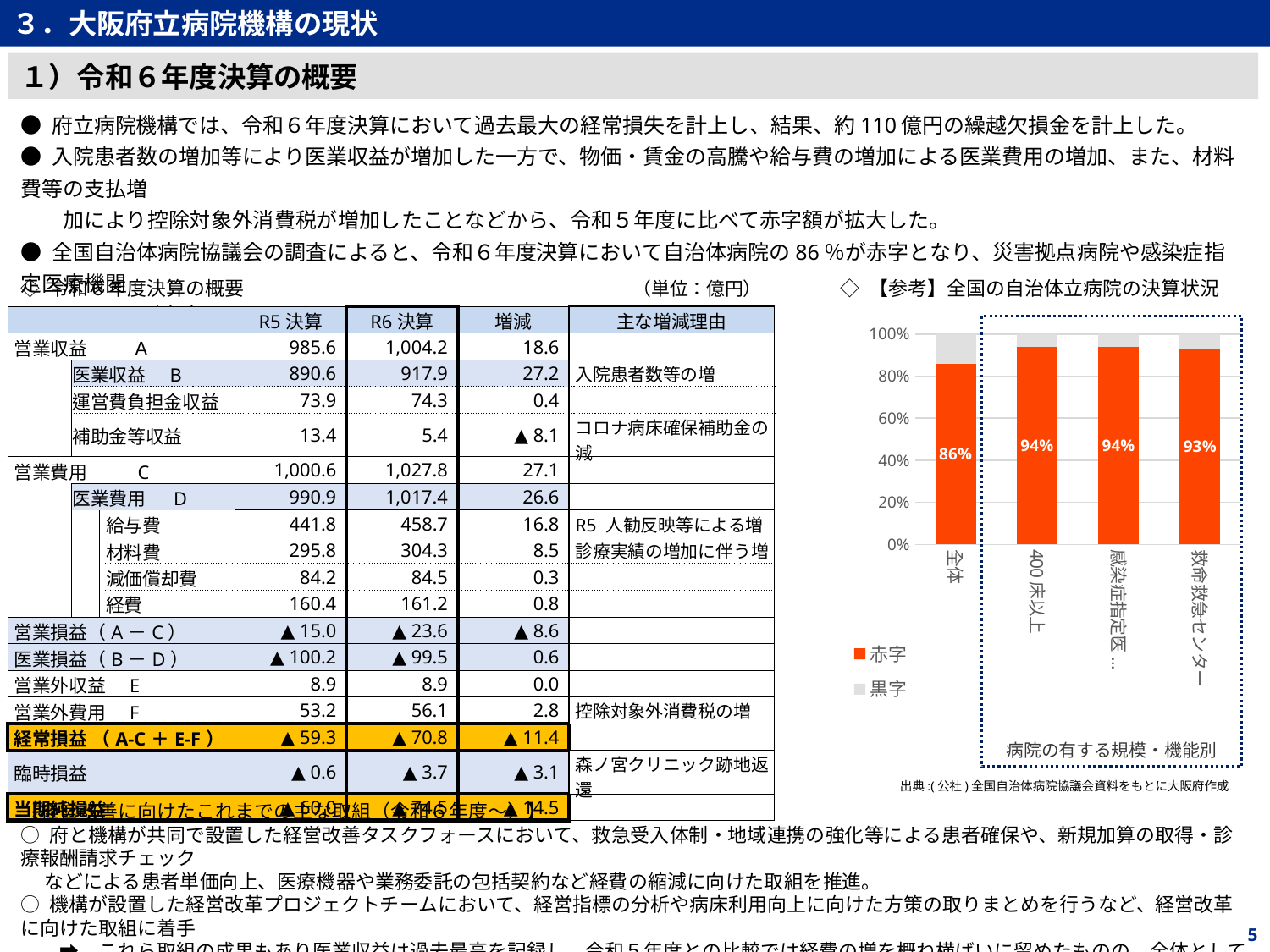
In the chart 【参考】全国の自治体立病院の決算状況, what is the difference between the 赤字 percentage for 400床以上 and for 全体? 8 percentage points What are the two legend entries in the chart 【参考】全国の自治体立病院の決算状況? 赤字 and 黒字 In the chart 【参考】全国の自治体立病院の決算状況, is the 赤字 value for 全体 greater or less than 80%? greater How many series does the legend of the chart 【参考】全国の自治体立病院の決算状況 list? 2 In the chart 【参考】全国の自治体立病院の決算状況, which category has the lowest 赤字 percentage? 全体 In the chart 【参考】全国の自治体立病院の決算状況, what is the 赤字 percentage for 400床以上? 94% In the chart 【参考】全国の自治体立病院の決算状況, what is the 赤字 percentage for 救命救急センター? 93% What kind of chart is shown on the right side of the slide under 【参考】全国の自治体立病院の決算状況? Stacked bar chart What is the x-axis label shown below the categories in the chart 【参考】全国の自治体立病院の決算状況? 病院の有する規模・機能別 In the chart 【参考】全国の自治体立病院の決算状況, what is the 赤字 percentage for 全体? 86% How many categories are shown on the x axis of the chart 【参考】全国の自治体立病院の決算状況? 4 In the chart 【参考】全国の自治体立病院の決算状況, which has a higher 赤字 percentage, 全体 or 救命救急センター? 救命救急センター